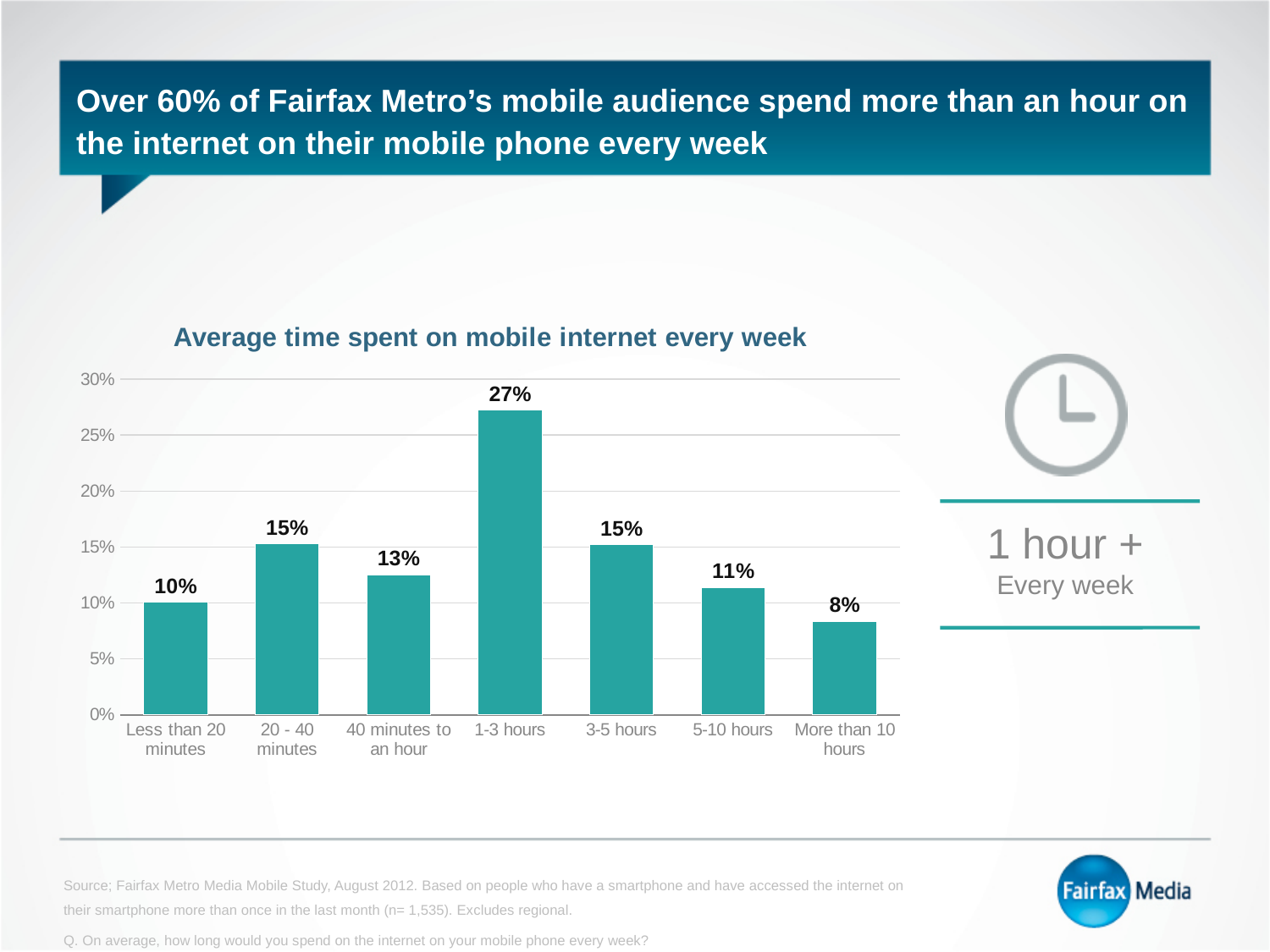
Which category has the highest value? 1-3 hours What is the value for the 'Less than 20 minutes' category? 10% What percentage of the mobile audience spends 1-3 hours on mobile internet every week? 27% What is the value for the 'More than 10 hours' category? 8% Which category has the lowest value? More than 10 hours What kind of chart is shown on the slide? Bar chart What is the value for the '5-10 hours' category? 11% How many categories are shown on the x axis? 7 Is the value for '1-3 hours' greater or less than 25%? greater What is the difference between the values for '1-3 hours' and '3-5 hours'? 12% Which is larger, the value for '40 minutes to an hour' or the value for '5-10 hours'? 40 minutes to an hour What is the title of the chart? Average time spent on mobile internet every week